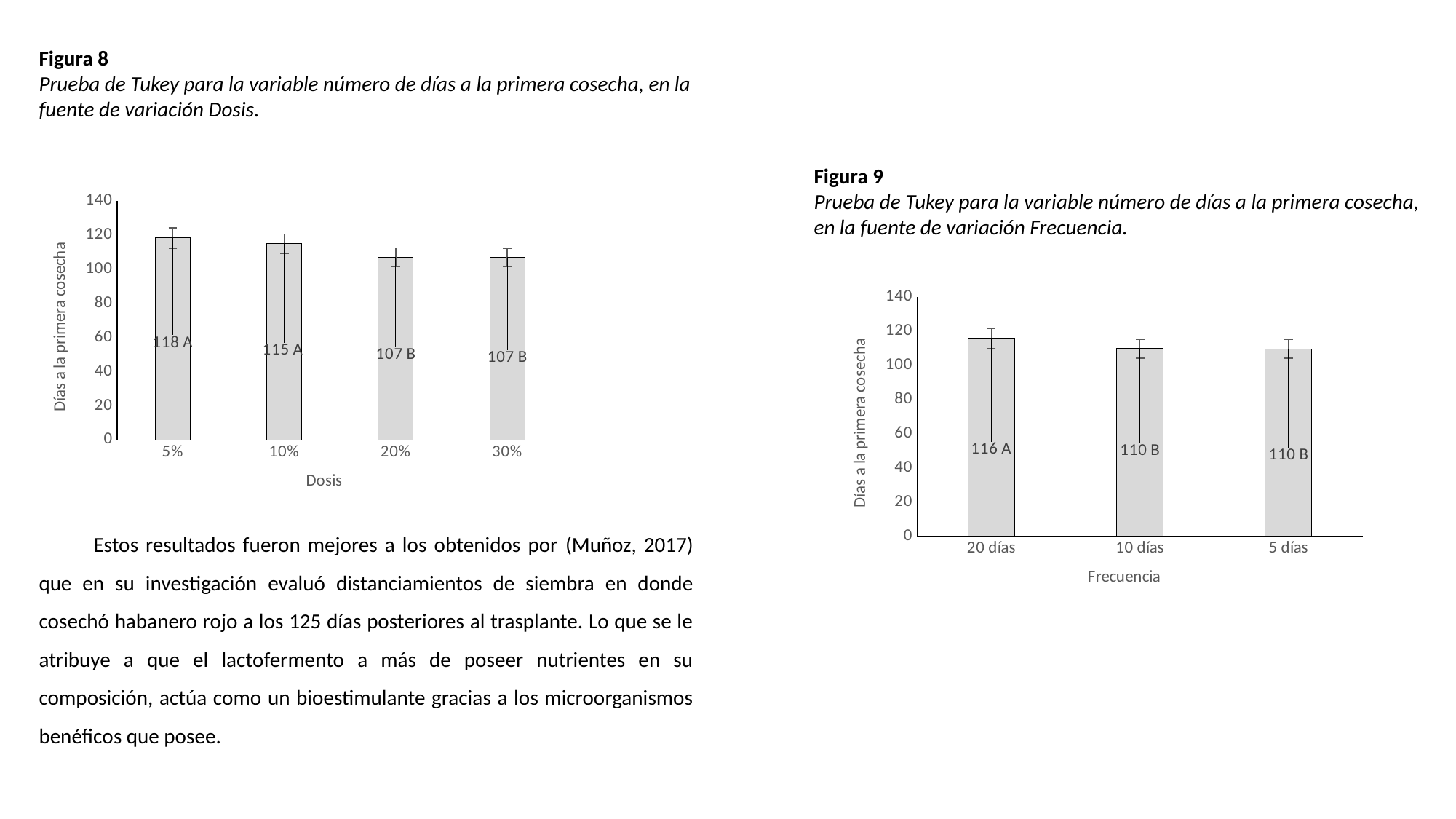
In Figura 9 (Frecuencia), which frecuencia has the highest number of days to first harvest? 20 días In Figura 8 (Dosis), what data label is printed on the bar for 5%? 118 A In Figura 8 (Dosis), do the values rise or fall as the dosis increases from 5% to 30%? fall What kind of chart is Figura 9 (Frecuencia)? bar chart In Figura 8 (Dosis), what data label is printed on the bar for 20%? 107 B In Figura 8 (Dosis), which dosis has the highest number of days to first harvest? 5% In Figura 9 (Frecuencia), what is the difference in days between the 20 días and 10 días bars? 6 In Figura 8 (Dosis), what is the difference in days between the 5% and 10% bars? 3 In Figura 8 (Dosis), how many dosis categories are shown on the x axis? 4 In Figura 9 (Frecuencia), is the value for 5 días greater or less than 100? greater In Figura 9 (Frecuencia), what data label is printed on the bar for 20 días? 116 A In Figura 8 (Dosis), which bar is taller, 10% or 30%? 10%